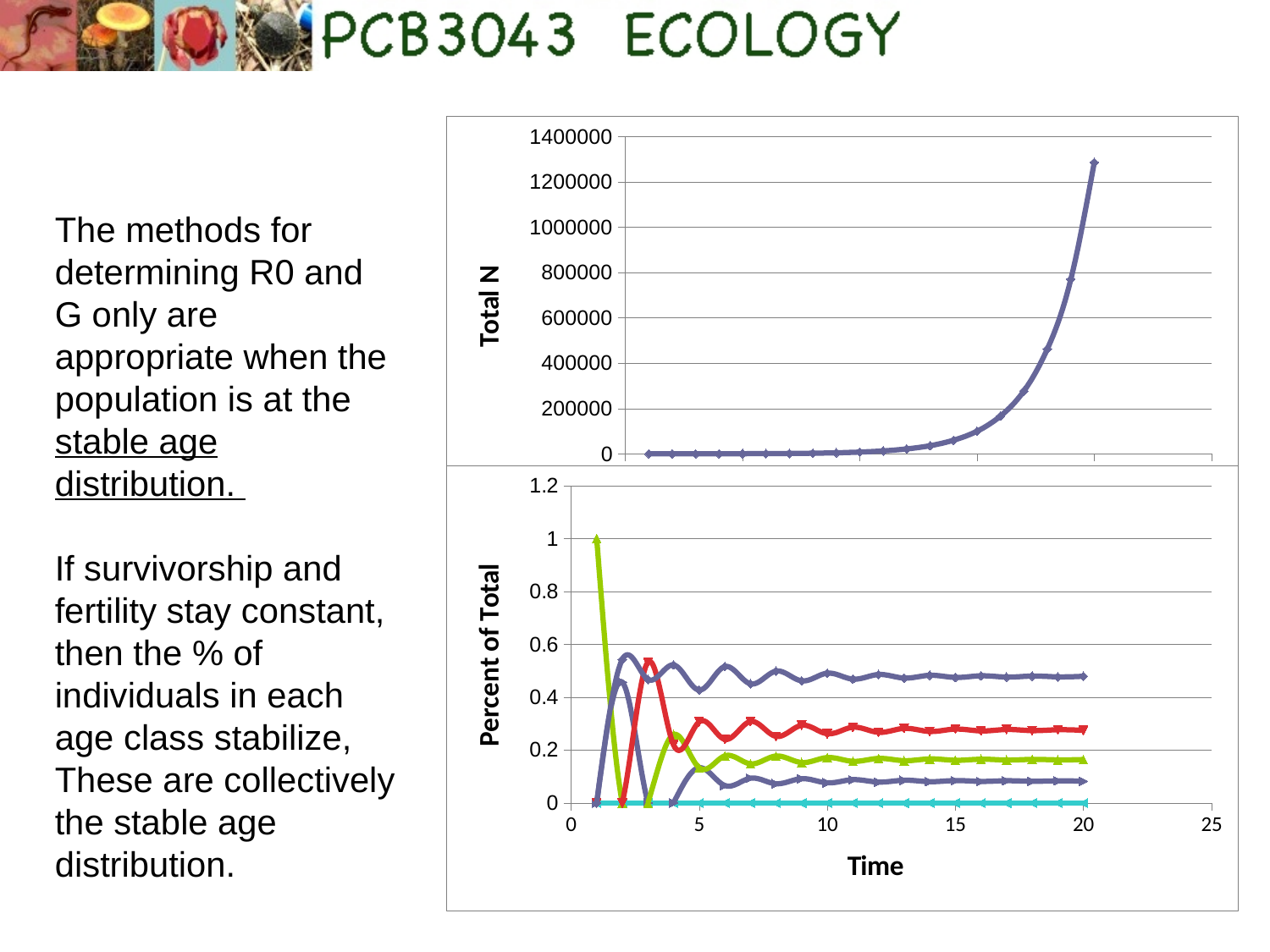
What kind of chart is the top chart (Total N)? line chart In the bottom chart, what is the value of the green line at time 1? 1 In the bottom chart, is the value of the upper blue line at time 20 greater or less than 0.4? greater In the bottom chart, which line has the highest value at time 20? the upper blue line In the bottom chart, what is the value of the cyan line at time 20? 0 In the top chart, is the value of the final (rightmost) point greater or less than 1200000? greater What kind of chart is the bottom chart (Percent of Total)? line chart In the bottom chart, is the value of the red line at time 20 greater or less than 0.4? less In the bottom chart, what is the label on the x axis? Time In the top chart, does Total N rise or fall as time increases? rises In the top chart, what is the label on the y axis? Total N In the bottom chart, at time 20, which is larger: the red line or the green line? the red line